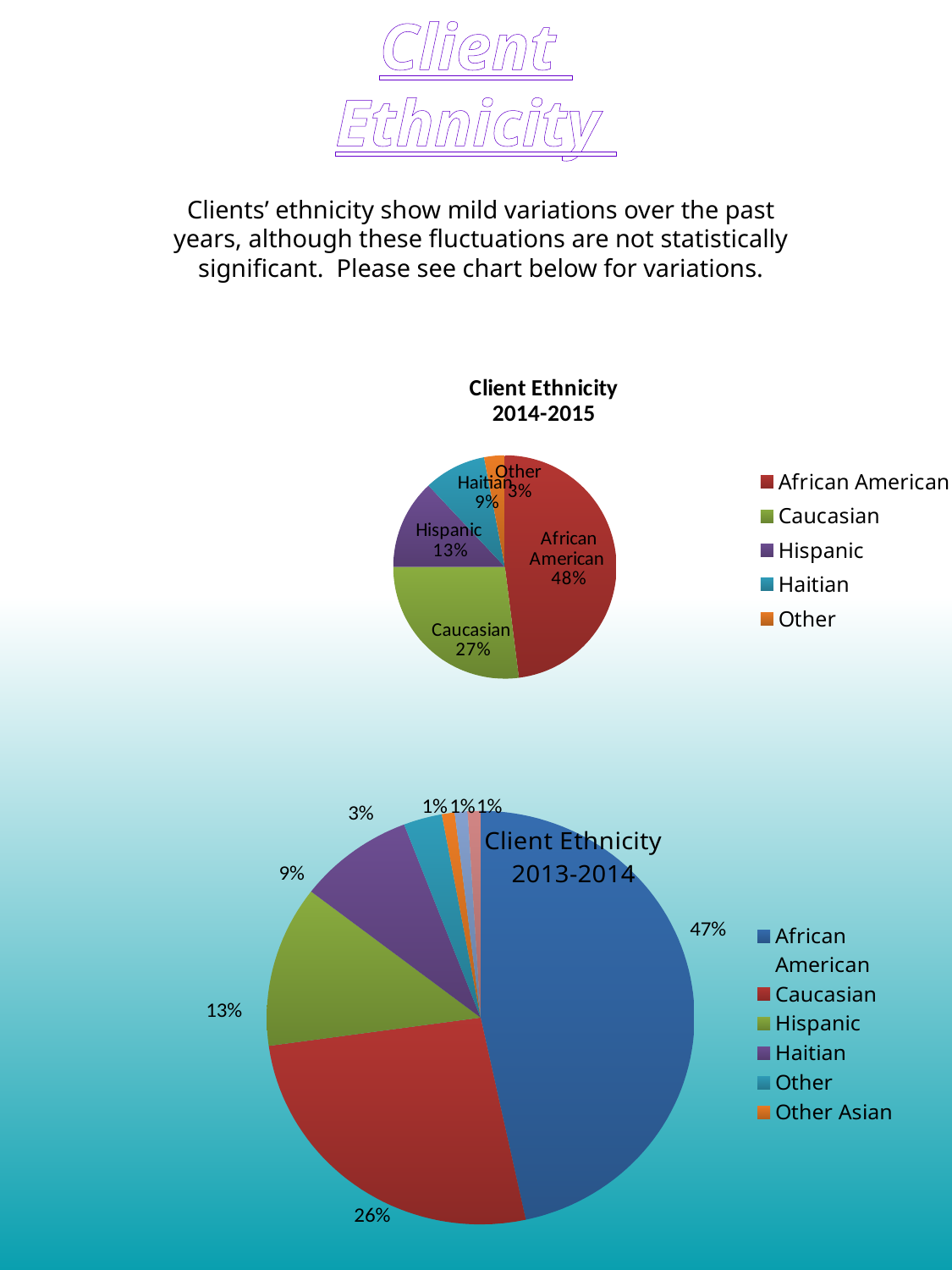
In the Client Ethnicity 2014-2015 chart, how many entries does the legend list? 5 In the Client Ethnicity 2014-2015 chart, what is the difference between the Caucasian and Hispanic shares? 14% In the Client Ethnicity 2013-2014 chart, how many entries does the legend list? 6 In the Client Ethnicity 2013-2014 chart, which category has the largest share? African American In the Client Ethnicity 2014-2015 chart, what percentage is Haitian? 9% In the Client Ethnicity 2013-2014 chart, what percentage is Caucasian? 26% Which chart shows a larger Caucasian share, Client Ethnicity 2014-2015 or Client Ethnicity 2013-2014? Client Ethnicity 2014-2015 In the Client Ethnicity 2014-2015 chart, which category has the smallest share? Other In the Client Ethnicity 2014-2015 chart, what percentage is African American? 48% What kind of charts are shown on the slide? Pie charts In the Client Ethnicity 2014-2015 chart, what percentage is Caucasian? 27% In the Client Ethnicity 2013-2014 chart, what percentage is African American? 47%